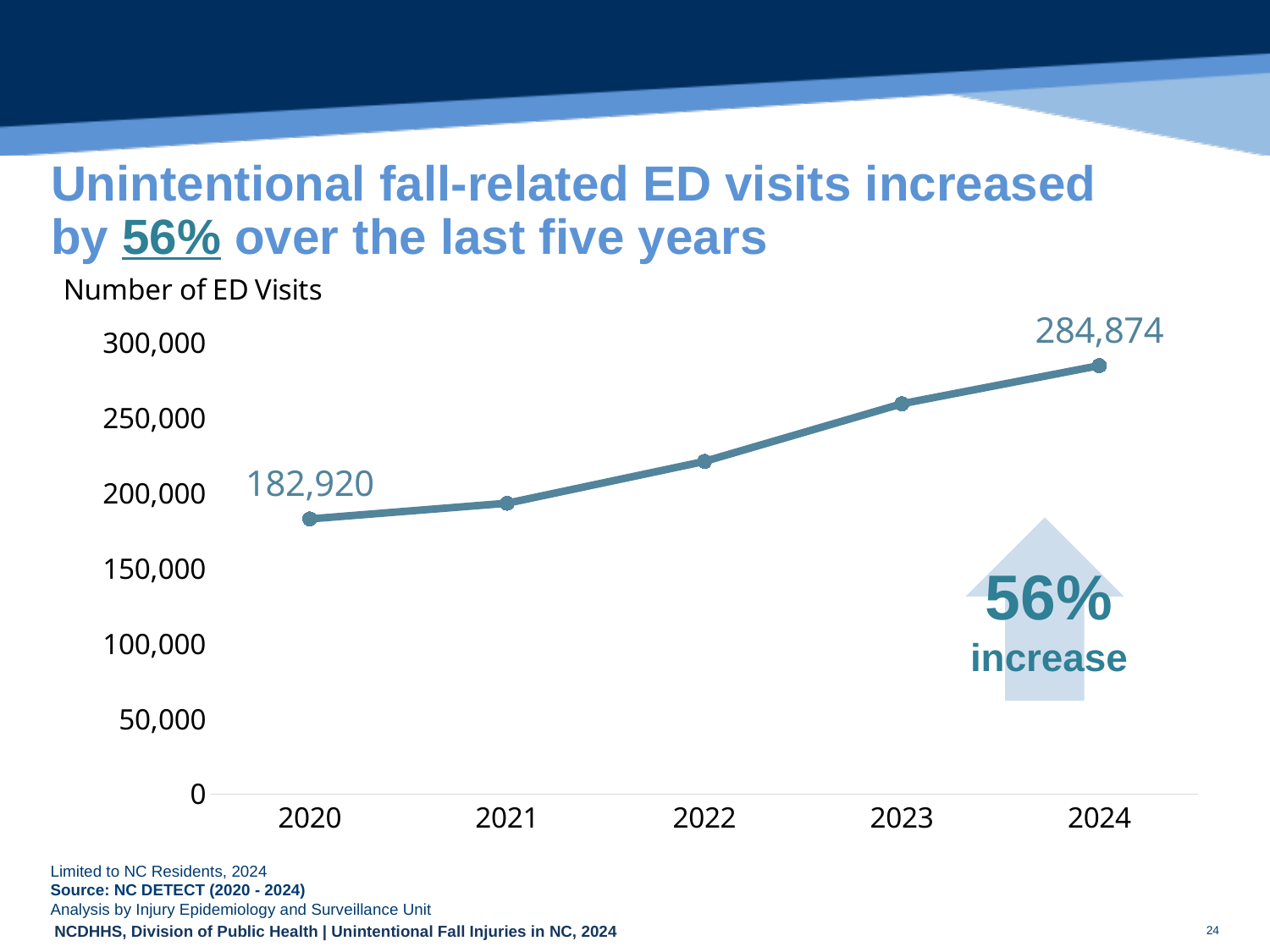
Is the value for 2022 greater or less than 200,000? greater Is the value for 2022 greater or less than 250,000? less Which year has the highest number of ED visits? 2024 What was the number of ED visits in 2024? 284,874 What type of chart is shown on the slide? Line chart Do the number of ED visits rise or fall from 2020 to 2024? Rise How many years are plotted on the chart? 5 What was the number of ED visits in 2020? 182,920 Which year has the lowest number of ED visits? 2020 Is the value for 2023 greater or less than 250,000? greater Which year had more ED visits, 2021 or 2023? 2023 What is the difference between the number of ED visits in 2024 and in 2020? 101,954